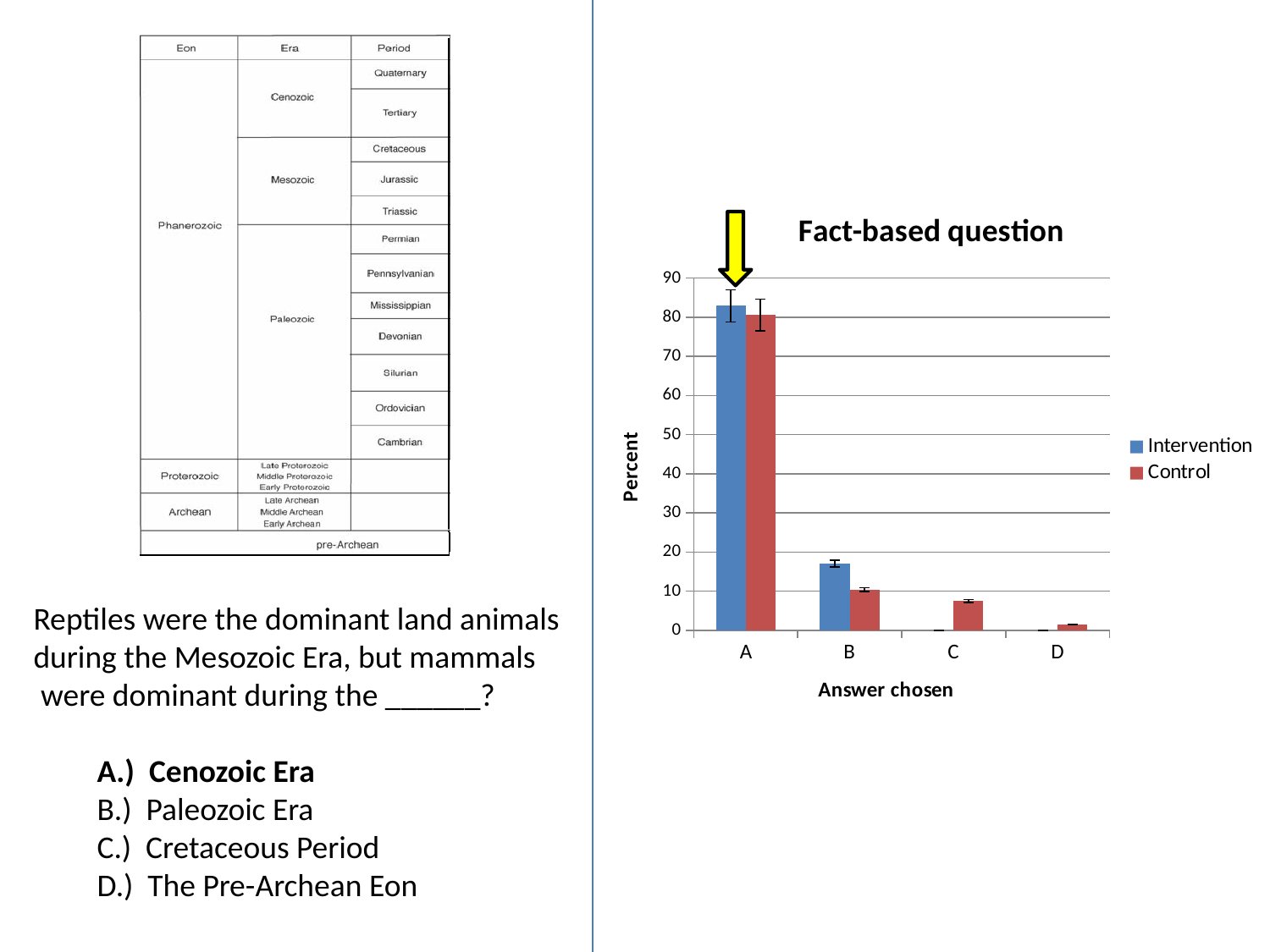
Is the Intervention value for answer B greater or less than 10? greater For answer B, which series has the larger value, Intervention or Control? Intervention Which answer chosen has the highest Control percentage? A How many series does the legend of the chart list? 2 What is the title of the chart? Fact-based question Which answer chosen has the lowest Control percentage? D Do the Control values rise or fall from answer A to answer D? fall Is the Control value for answer C greater or less than 10? less How many answer categories are shown on the x axis of the chart? 4 Which answer chosen has the highest Intervention percentage? A What kind of chart is shown on the slide? bar chart Is the Intervention value for answer A greater or less than 70? greater